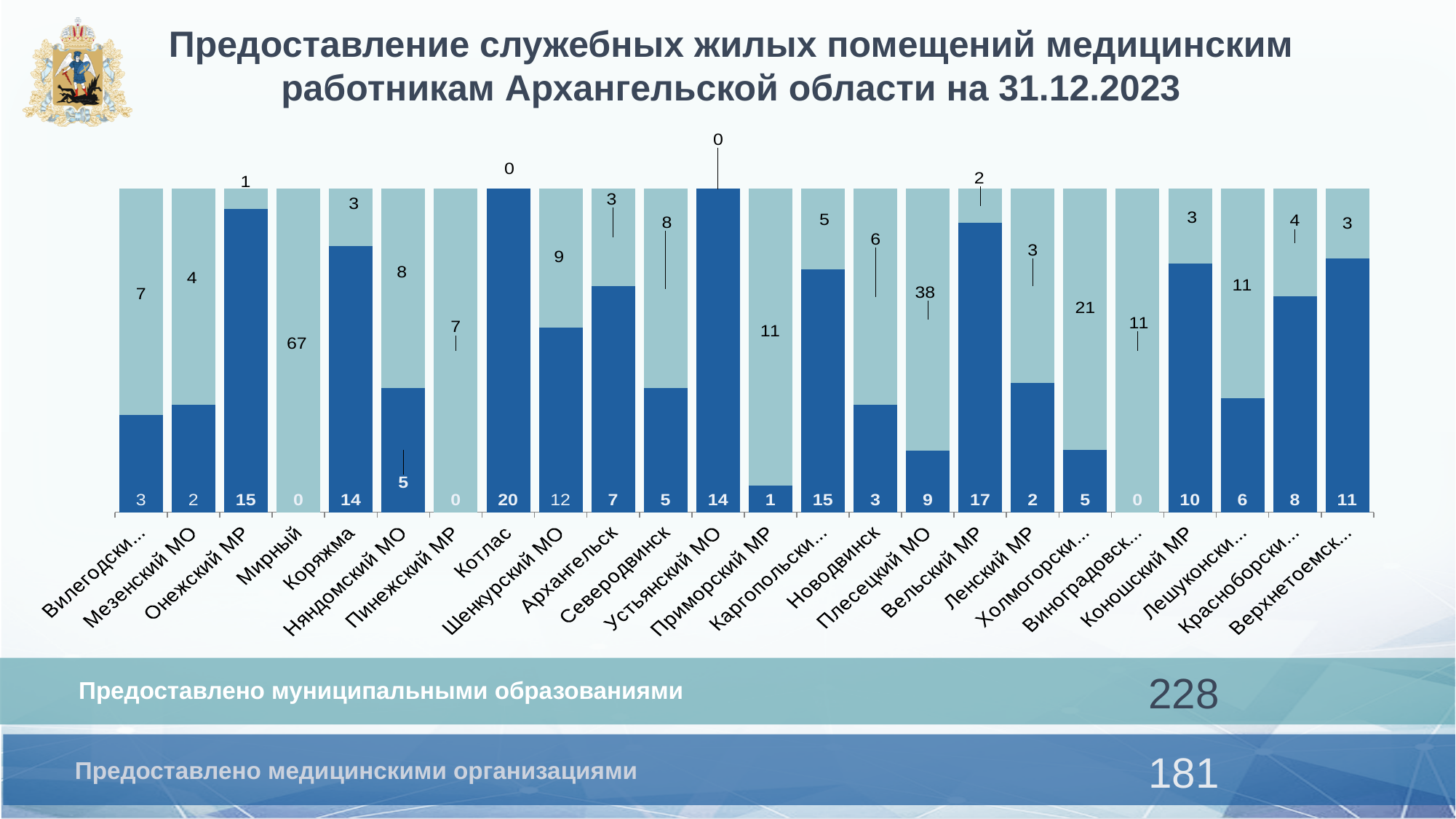
Which category has the highest light blue (top) segment value? Мирный What is the total of the two segments for Плесецкий МО? 47 Which category has the highest dark blue (bottom) segment value? Котлас What is the value of the light blue (top) segment for Плесецкий МО? 38 How many categories (municipalities) are shown along the x axis of the chart? 24 What is the value of the light blue (top) segment for Мирный? 67 What is the value of the dark blue (bottom) segment for Вельский МР? 17 What is the total of the two segments for Мезенский МО? 6 What is the difference between the dark blue (bottom) values for Вельский МР and Коряжма? 3 Which has the larger dark blue (bottom) value, Архангельск or Северодвинск? Архангельск What kind of chart is shown on the slide? Stacked bar chart What is the value of the dark blue (bottom) segment for Котлас? 20